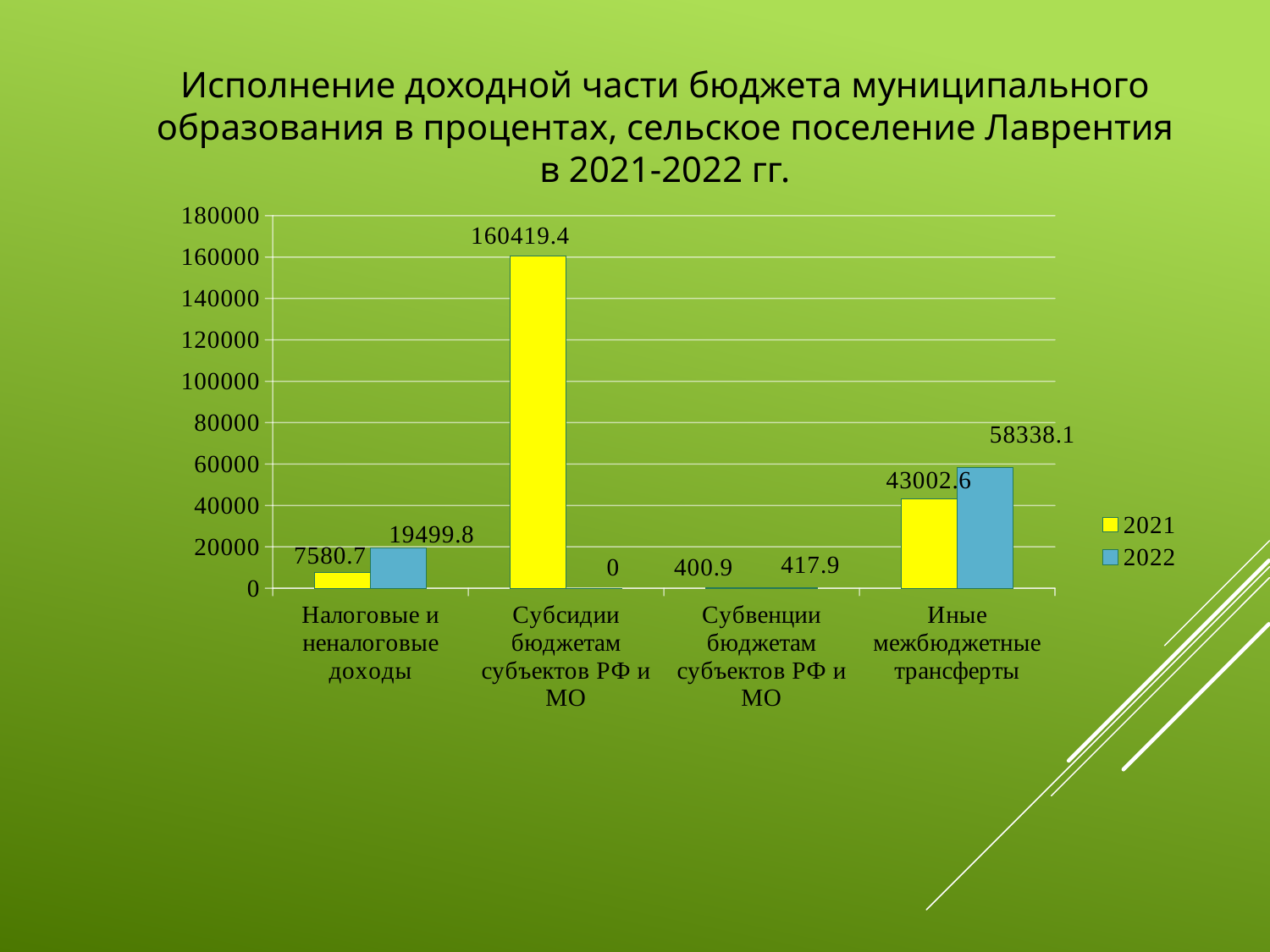
What is the 2022 value for Иные межбюджетные трансферты? 58338.1 What is the 2022 value for Субвенции бюджетам субъектов РФ и МО? 417.9 What is the 2021 value for Налоговые и неналоговые доходы? 7580.7 What is the difference between the 2022 and 2021 values for Иные межбюджетные трансферты? 15335.5 What kind of chart is shown on the slide? Bar chart How many categories are shown on the x axis? 4 Which is larger for Иные межбюджетные трансферты, the 2021 value or the 2022 value? 2022 What is the 2021 value for Субсидии бюджетам субъектов РФ и МО? 160419.4 How many series does the legend list? 2 Which category has the lowest 2022 value? Субсидии бюджетам субъектов РФ и МО Which category has the highest 2021 value? Субсидии бюджетам субъектов РФ и МО What is the difference between the 2022 and 2021 values for Налоговые и неналоговые доходы? 11919.1